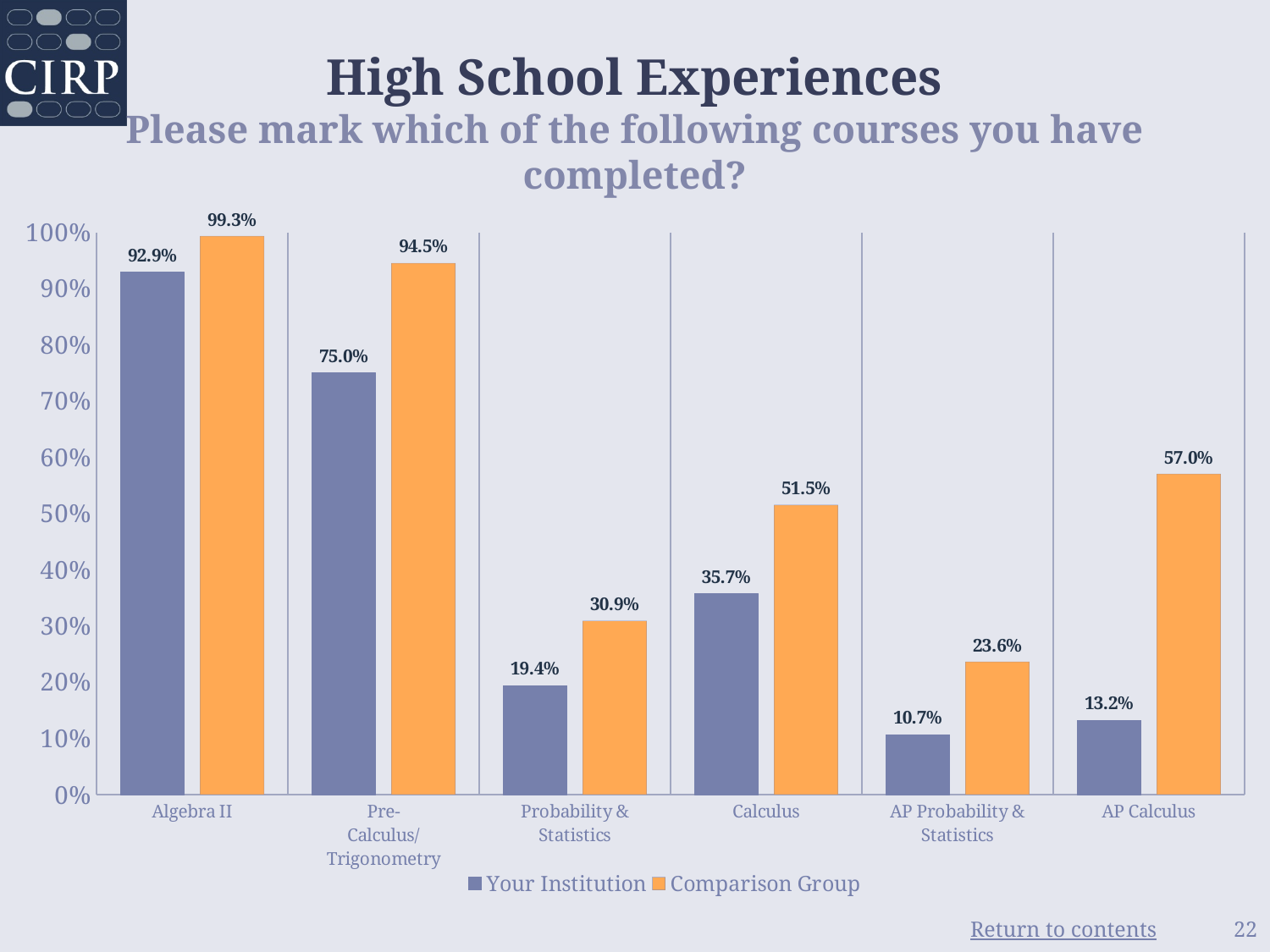
What is the value for Comparison Group for AP Calculus? 57.0% Is the Comparison Group value for Calculus greater or less than 50%? greater Which course has the highest Comparison Group value? Algebra II Which is larger for Pre-Calculus/Trigonometry: Your Institution or Comparison Group? Comparison Group How many series does the legend list? 2 What colour are the Comparison Group bars? orange How many courses are shown on the x axis? 6 What is the value for Your Institution for Algebra II? 92.9% What kind of chart is shown on the slide? bar chart Which course has the lowest Your Institution value? AP Probability & Statistics What is the value for Your Institution for Calculus? 35.7% What is the difference between the Comparison Group and Your Institution values for AP Calculus? 43.8%